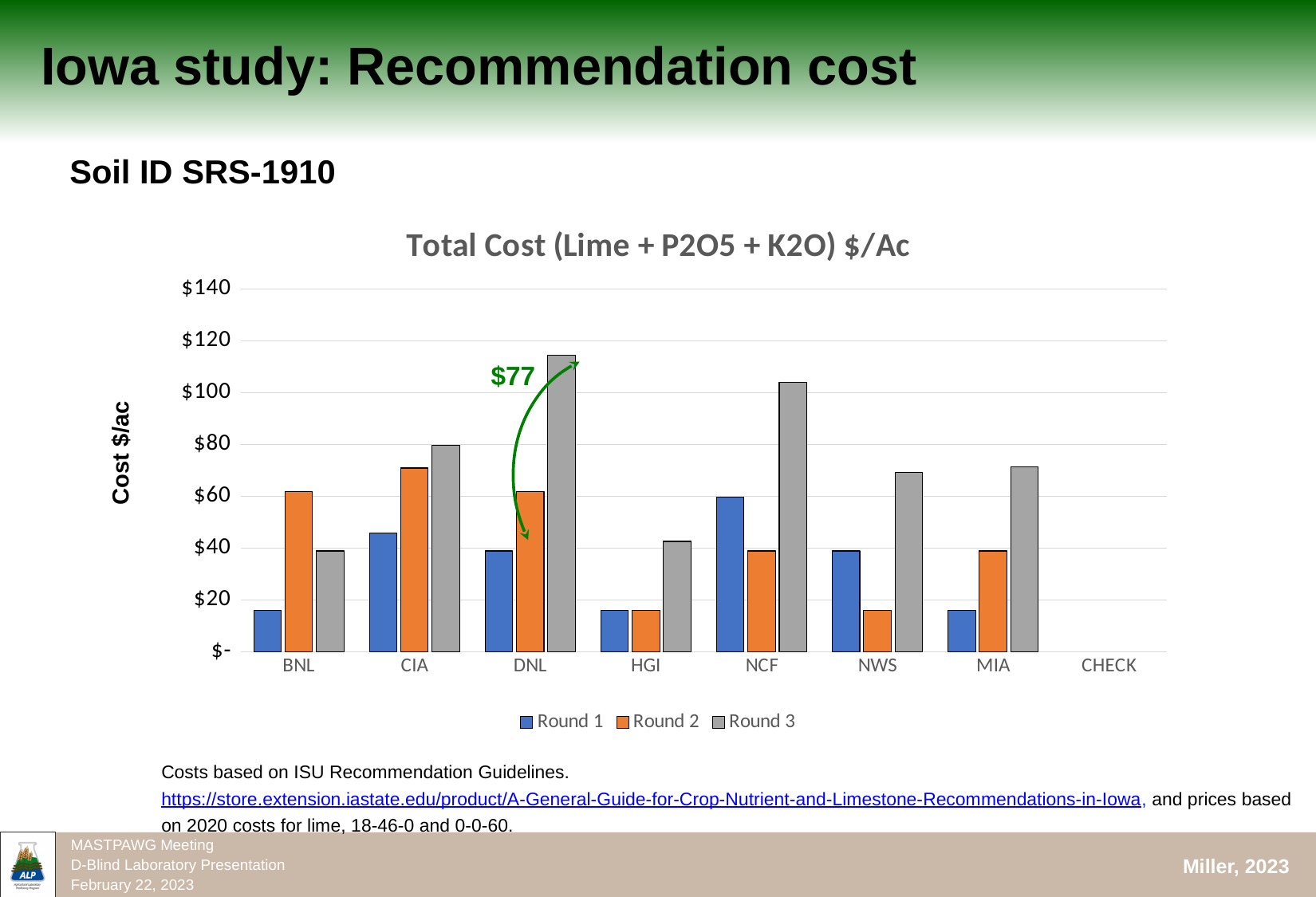
How many series does the chart's legend list? 3 Is the Round 2 value for CIA greater or less than $60? greater What kind of chart is shown on the slide? bar chart How many categories are shown on the x axis of the chart? 8 Is the Round 3 value for DNL greater or less than $100? greater Is the Round 1 value for BNL greater or less than $20? less What value does the green annotation next to the DNL bars show? $77 For MIA, which is larger: the Round 1 value or the Round 2 value? Round 2 Which category has the highest Round 3 bar? DNL For NCF, which is larger: the Round 1 value or the Round 2 value? Round 1 What is the title of the chart? Total Cost (Lime + P2O5 + K2O) $/Ac